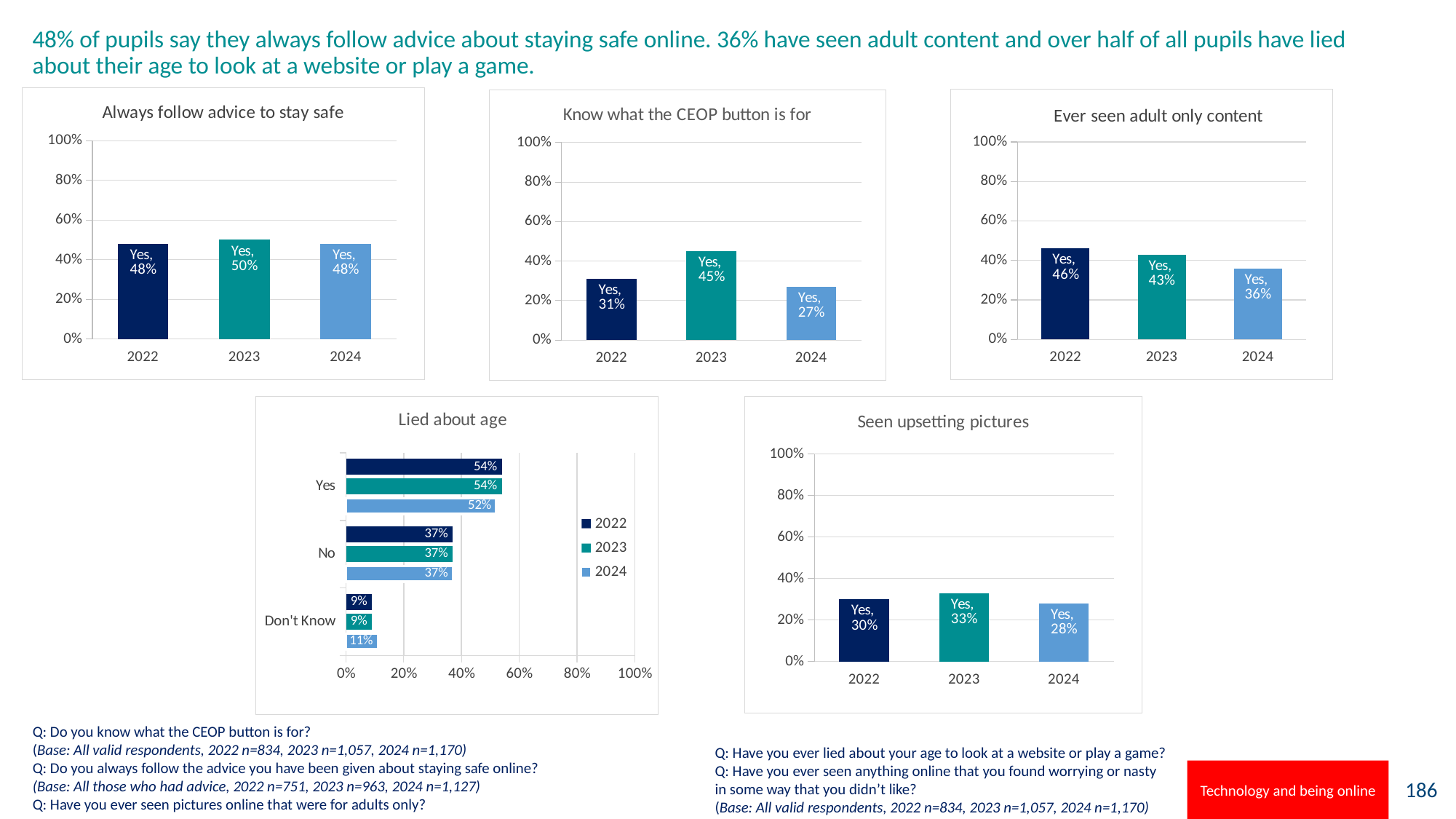
In the 'Lied about age' chart, how many series does the legend list? 3 In the 'Ever seen adult only content' chart, which year has the lowest value? 2024 In the 'Always follow advice to stay safe' chart, what is the value for 2023? 50% In the 'Lied about age' chart, what is the 2024 value for 'Don't Know'? 11% How many charts are shown on the slide? 5 In the 'Know what the CEOP button is for' chart, which year has the highest value? 2023 In the 'Seen upsetting pictures' chart, is the value for 2024 greater or less than 40%? less What kind of chart is the 'Lied about age' chart? bar chart In the 'Lied about age' chart, how many categories are shown on the vertical axis? 3 In the 'Know what the CEOP button is for' chart, what is the difference between the 2023 and 2024 values? 18% In the 'Seen upsetting pictures' chart, which is larger, the value for 2022 or 2023? 2023 In the 'Ever seen adult only content' chart, do values rise or fall from 2022 to 2024? fall